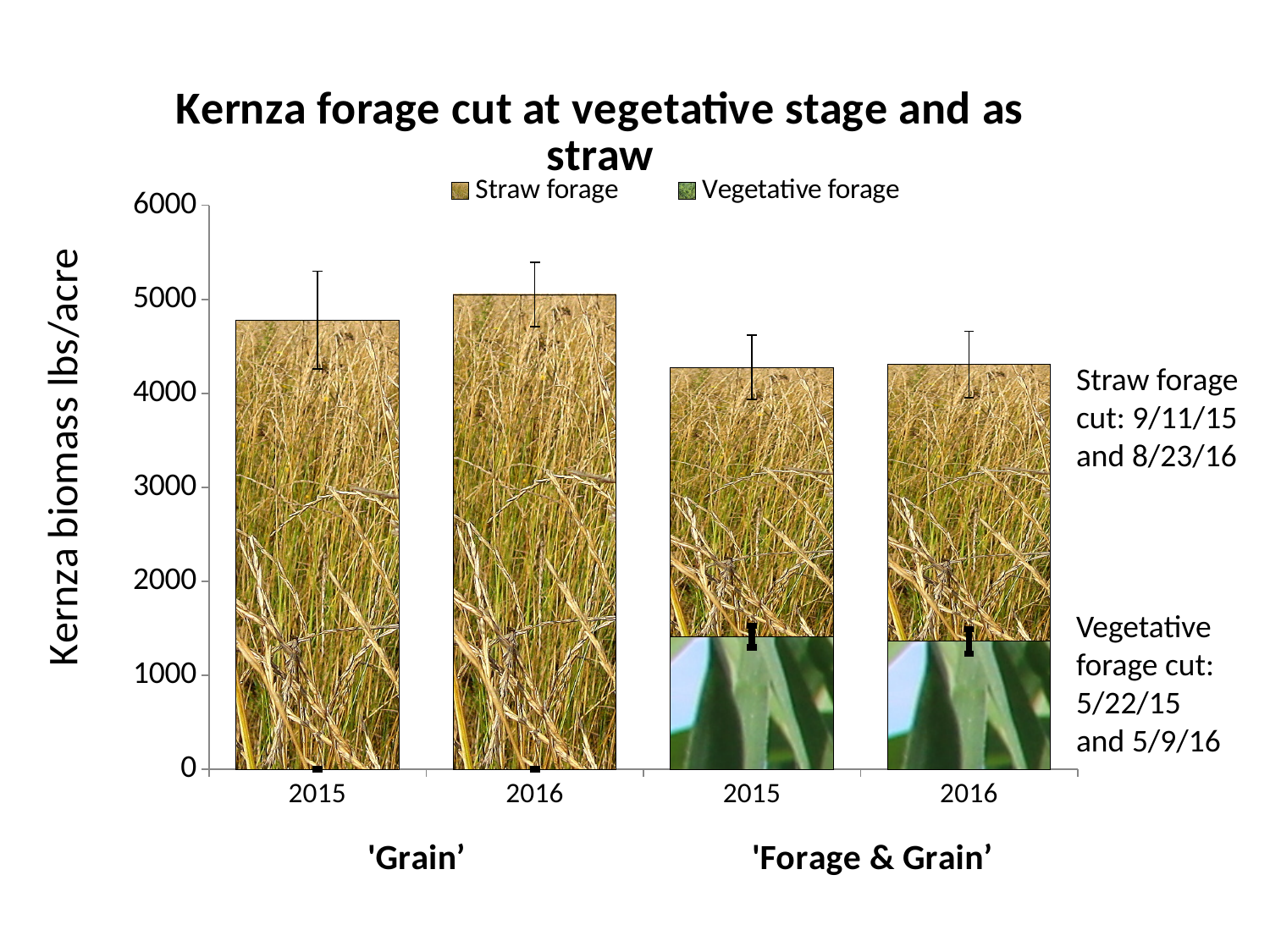
Which is larger, the total biomass for 'Grain' 2015 or 'Grain' 2016? 'Grain' 2016 Is the Vegetative forage value for 'Forage & Grain' 2015 greater or less than 2000? less What are the two series named in the legend? Straw forage and Vegetative forage Is the total biomass for 'Grain' 2015 greater or less than 4000? greater How many series does the legend list? 2 Which is larger, the total biomass for 'Grain' 2015 or 'Forage & Grain' 2015? 'Grain' 2015 Is the total biomass for 'Forage & Grain' 2015 greater or less than 5000? less How many bars are plotted in the chart? 4 What is the label of the y axis? Kernza biomass lbs/acre Which bar has the highest total Kernza biomass? 'Grain' 2016 What kind of chart is shown on the slide? Stacked bar chart